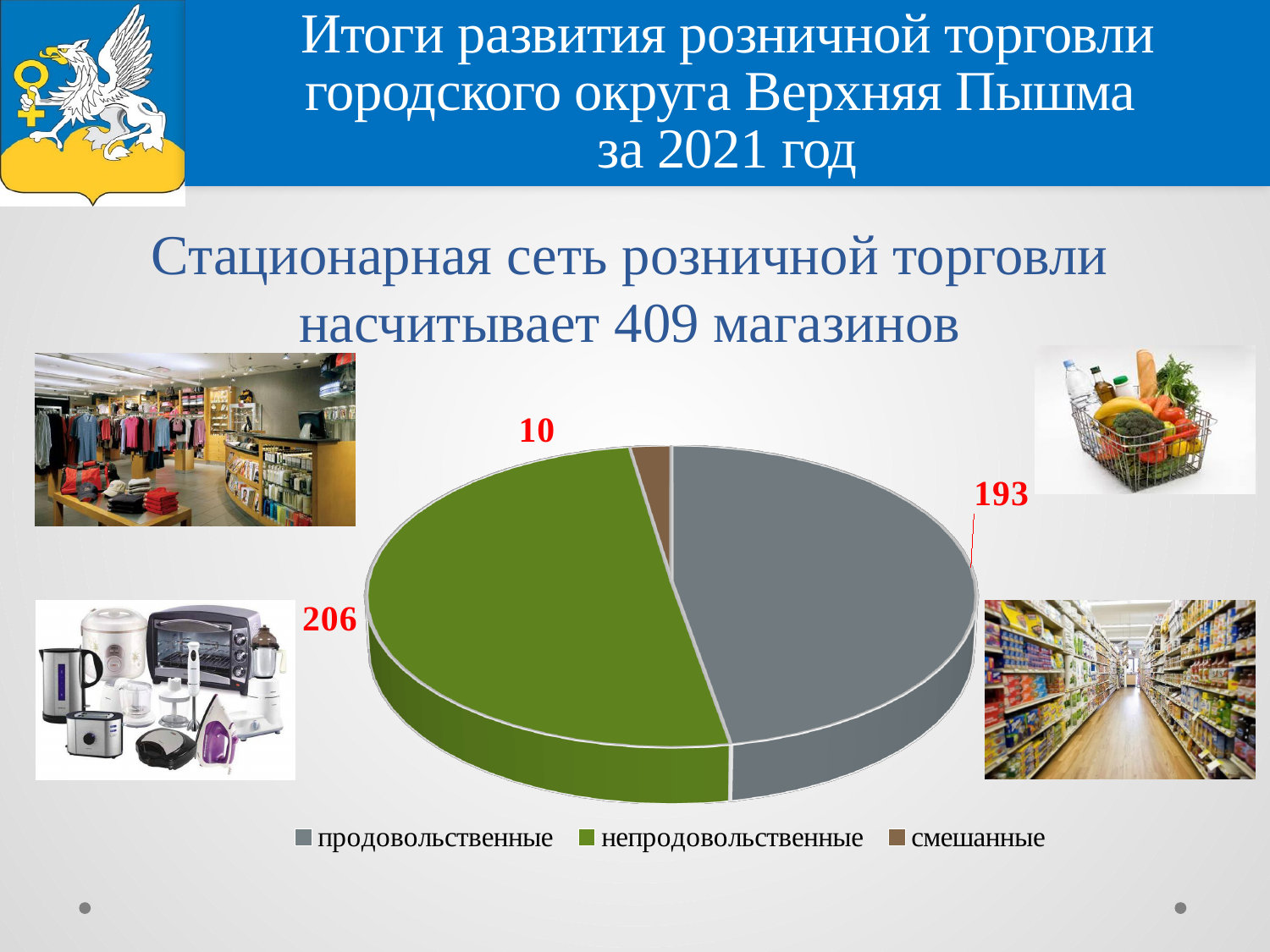
How many slices does the pie chart have? 3 What is the value for продовольственные in the pie chart? 193 What type of chart is shown on the slide? pie chart Which is larger, the value for продовольственные or the value for смешанные? продовольственные How many entries does the legend of the pie chart list? 3 What is the total of all three slices in the pie chart? 409 What is the value for непродовольственные in the pie chart? 206 What is the value for смешанные in the pie chart? 10 Which category has the largest slice in the pie chart? непродовольственные Which colour represents смешанные in the pie chart? brown What is the difference between the values for непродовольственные and продовольственные? 13 Which category has the smallest slice in the pie chart? смешанные